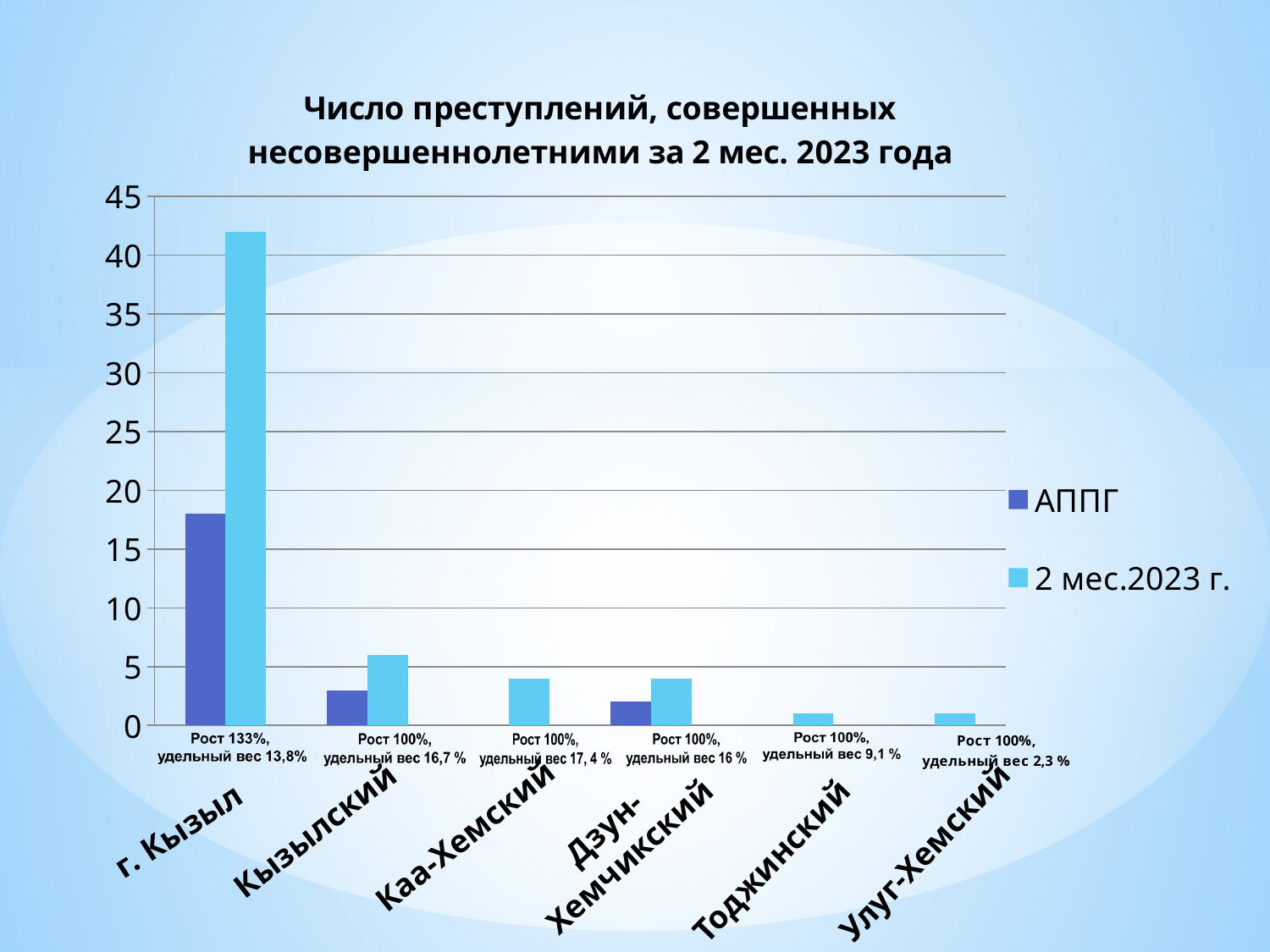
What share (удельный вес) is printed for Улуг-Хемский? 2,3 % Is the value for Кызылский in the series 2 мес.2023 г. greater or less than 5? greater What growth percentage and share are printed under the г. Кызыл bars? Рост 133%, удельный вес 13,8% How many series does the legend list? 2 What is the title of the chart? Число преступлений, совершенных несовершеннолетними за 2 мес. 2023 года Which category has the highest value for the series АППГ? г. Кызыл Is the value for г. Кызыл in the series 2 мес.2023 г. greater or less than 40? greater What kind of chart is shown on the slide? bar chart How many categories (districts) are shown on the x axis? 6 Is the value for г. Кызыл in the series АППГ greater or less than 20? less For г. Кызыл, which series has the larger value, АППГ or 2 мес.2023 г.? 2 мес.2023 г. Which category has the highest value for the series 2 мес.2023 г.? г. Кызыл